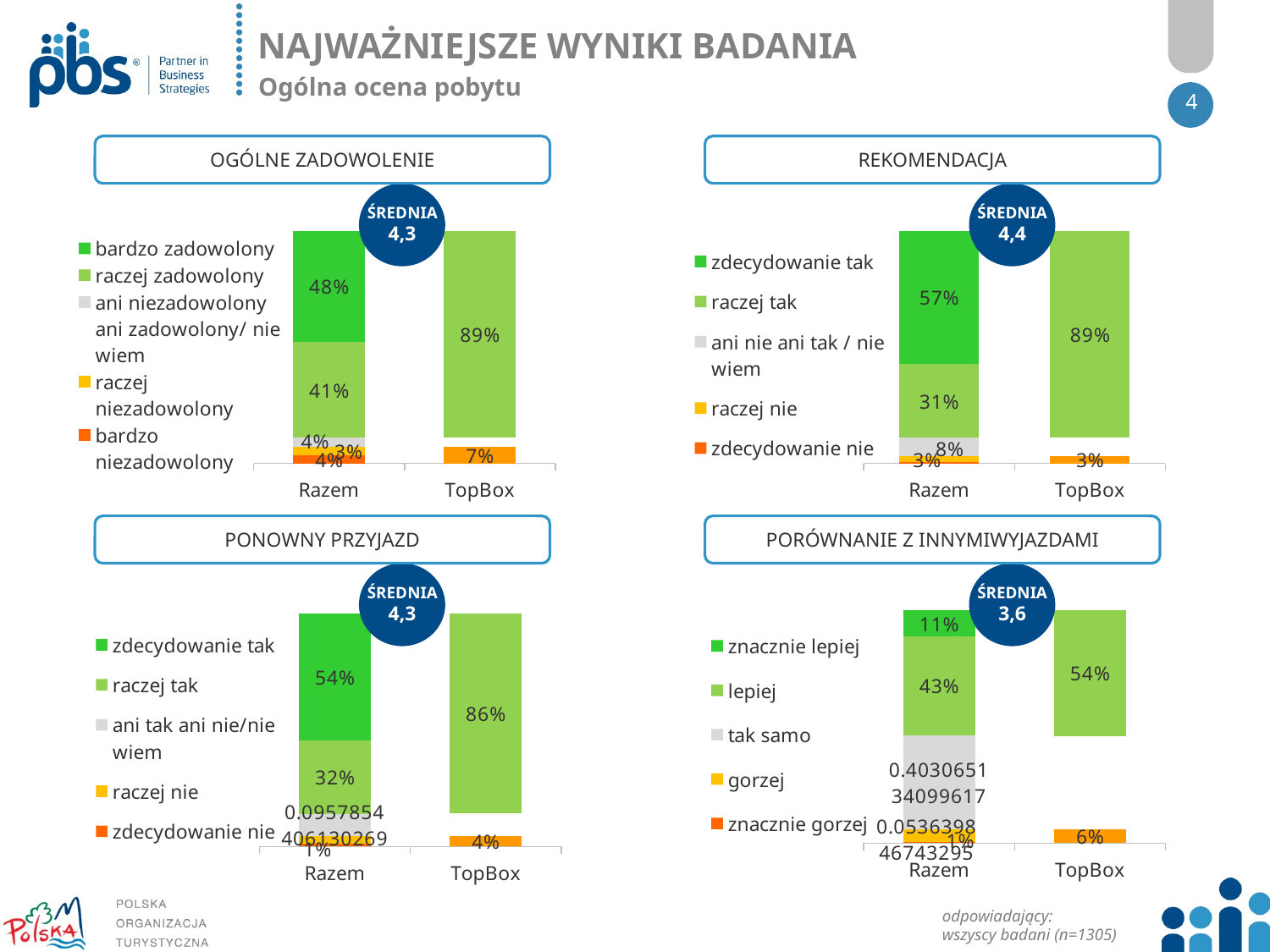
In the PORÓWNANIE Z INNYMI WYJAZDAMI chart, what is the value for 'lepiej' in the Razem bar? 43% In the OGÓLNE ZADOWOLENIE chart, what is the value of the orange segment in the TopBox bar? 7% In the REKOMENDACJA chart, what is the value for 'raczej tak' in the Razem bar? 31% In the REKOMENDACJA chart, what is the difference between 'zdecydowanie tak' (57%) and 'raczej tak' (31%) in the Razem bar? 26 percentage points What type of chart is the OGÓLNE ZADOWOLENIE chart? Stacked bar chart In the PONOWNY PRZYJAZD chart, what is the value of the large green segment in the TopBox bar? 86% What ŚREDNIA (average) value is shown on the REKOMENDACJA chart? 4,4 How many entries does the legend of the PORÓWNANIE Z INNYMI WYJAZDAMI chart list? 5 What ŚREDNIA (average) value is shown on the PORÓWNANIE Z INNYMI WYJAZDAMI chart? 3,6 How many categories are shown on the x axis of the REKOMENDACJA chart? 2 In the OGÓLNE ZADOWOLENIE chart, what percentage of the Razem bar is 'bardzo zadowolony'? 48% In the PONOWNY PRZYJAZD chart, which is larger in the Razem bar: 'zdecydowanie tak' or 'raczej tak'? zdecydowanie tak